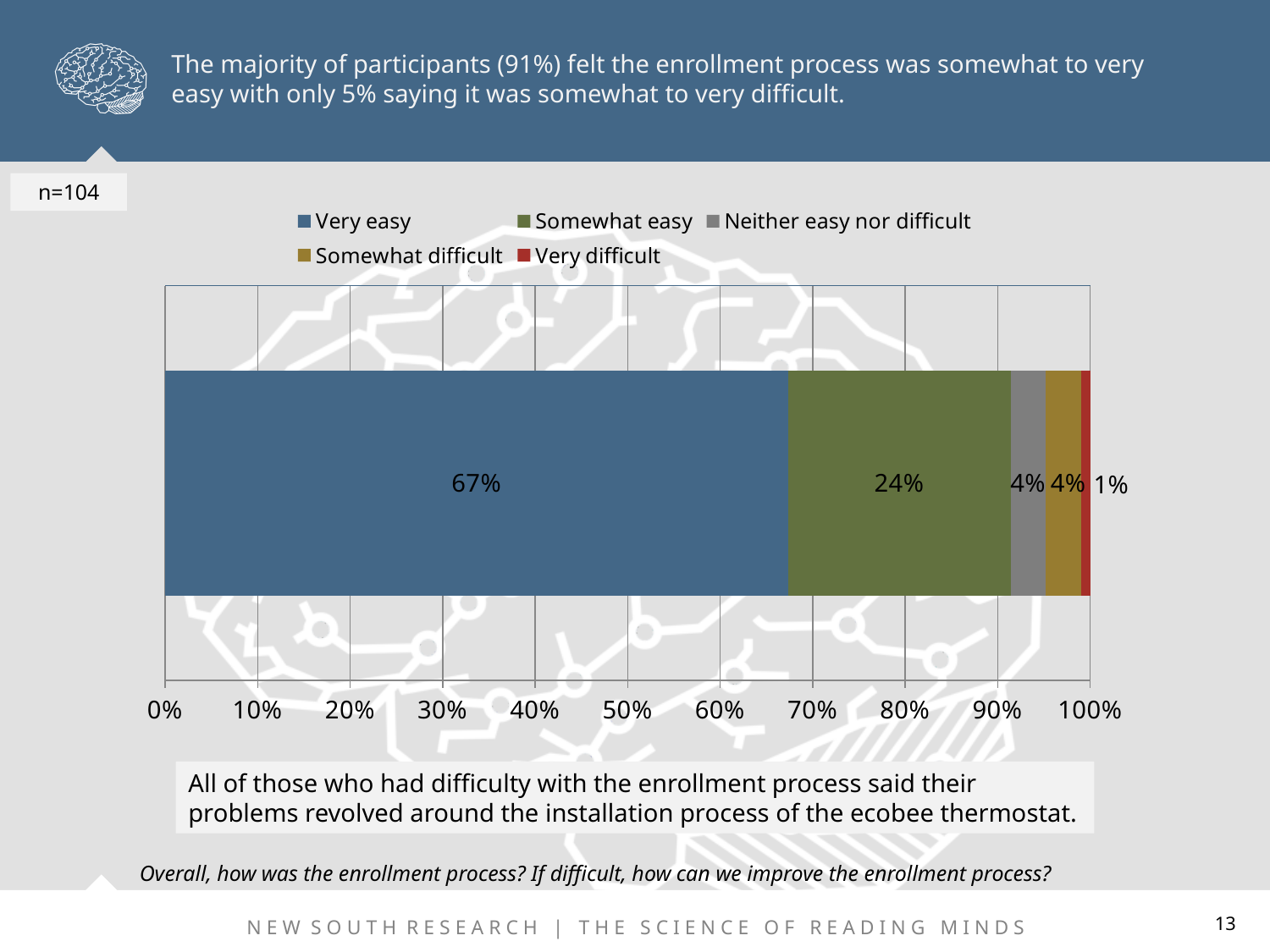
What percentage of participants said the enrollment process was somewhat easy? 24% What sample size (n) is shown on the slide? n=104 What kind of chart is shown on the slide? Stacked bar chart What percentage of participants said the enrollment process was neither easy nor difficult? 4% What is the difference in percentage points between the 'Very easy' and 'Somewhat easy' responses? 43 How many series does the legend list? 5 What percentage of participants said the enrollment process was very easy? 67% Which is larger, the share for 'Somewhat easy' or the share for 'Somewhat difficult'? Somewhat easy Which response category has the largest share of participants? Very easy What percentage of participants said the enrollment process was very difficult? 1% Is the value for 'Very easy' greater or less than 60%? greater Which response category has the smallest share of participants? Very difficult